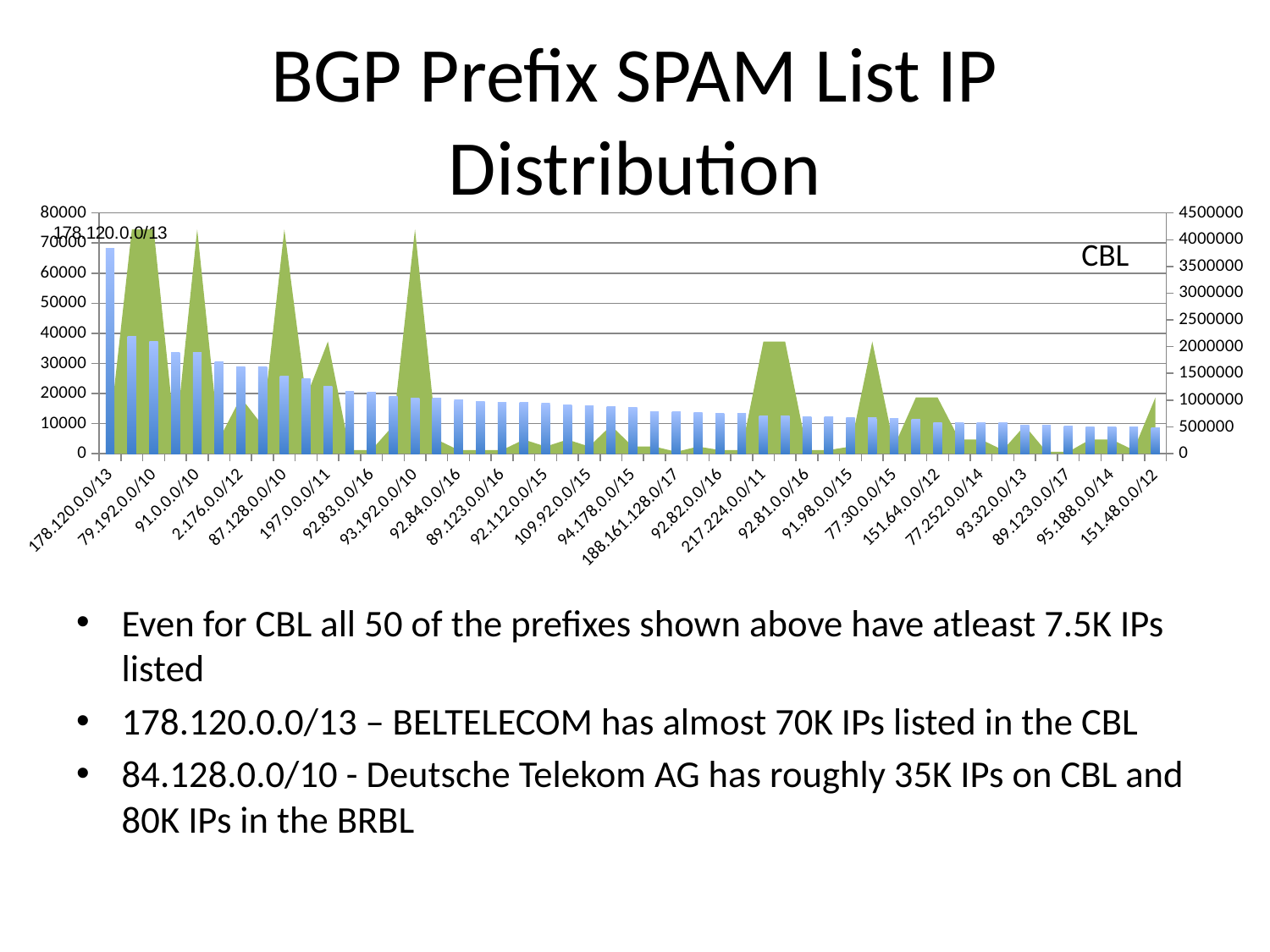
Is the blue bar value for 79.192.0.0/10 greater or less than 30000? greater What kind of chart is used for the blue CBL series on the slide? bar chart What is the maximum value shown on the left vertical axis of the chart? 80000 Is the blue bar value for 178.120.0.0/13 greater or less than 60000? greater Is the blue bar value for 87.128.0.0/10 greater or less than 20000? greater What series label is printed in the upper right of the chart area? CBL Which has the larger blue bar, 178.120.0.0/13 or 79.192.0.0/10? 178.120.0.0/13 Which prefix has the highest blue bar in the chart? 178.120.0.0/13 How many prefixes are shown in the chart, according to the slide? 50 Do the blue bar values rise or fall moving from left to right along the x axis? fall